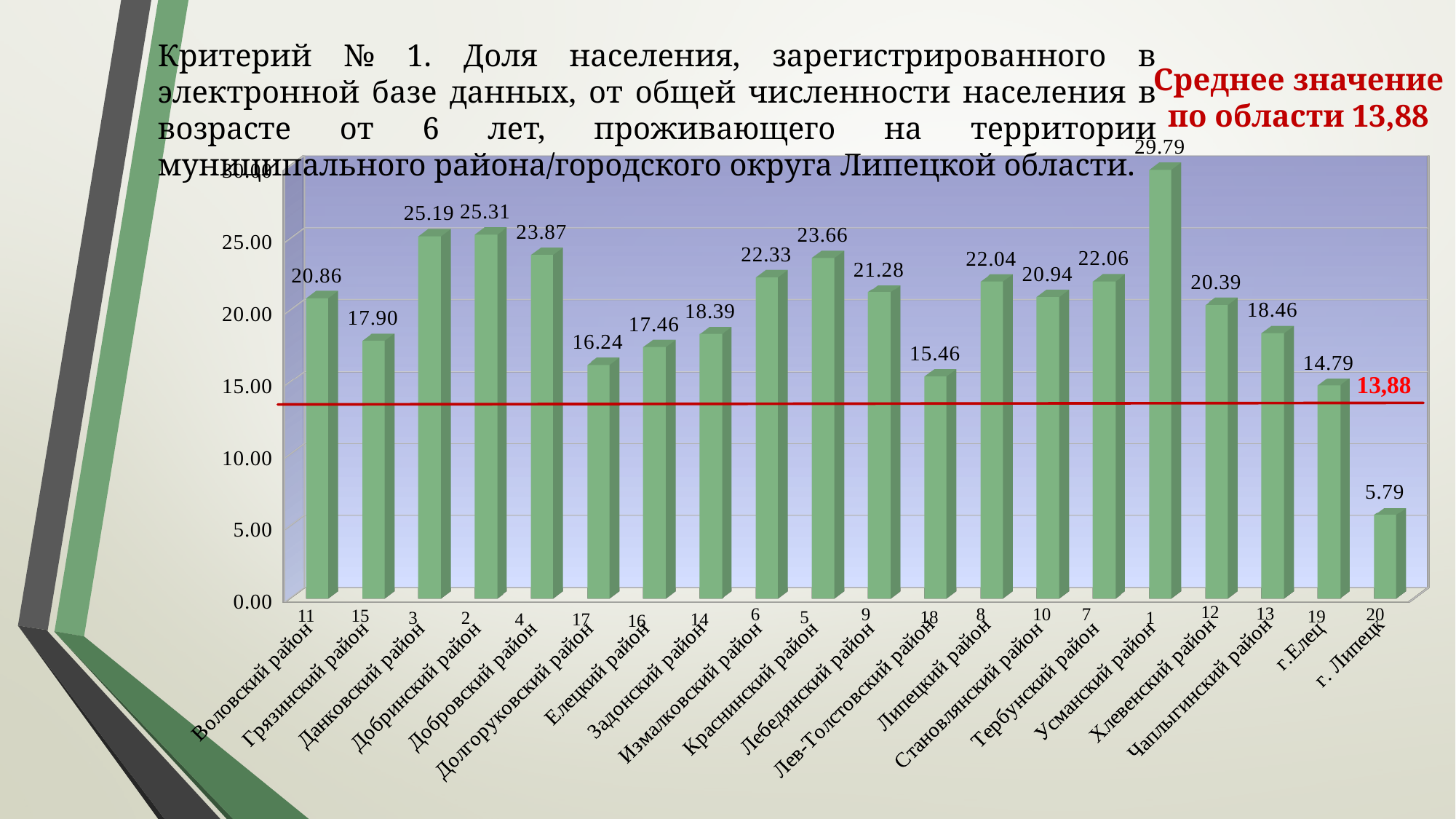
What is the value for г. Липецк? 5.79 What kind of chart is shown on the slide? Bar chart What value does the red horizontal line on the chart mark? 13,88 Which category has the lowest value? г. Липецк How many categories are shown on the chart? 20 What is the value for Лев-Толстовский район? 15.46 Which category has the highest value? Усманский район What is the difference between the values for Усманский район and г. Липецк? 24.00 What is the value for Воловский район? 20.86 What is the value for Усманский район? 29.79 What is the difference between the values for Добровский район and Долгоруковский район? 7.63 Which is larger, the value for Краснинский район or the value for Лебедянский район? Краснинский район